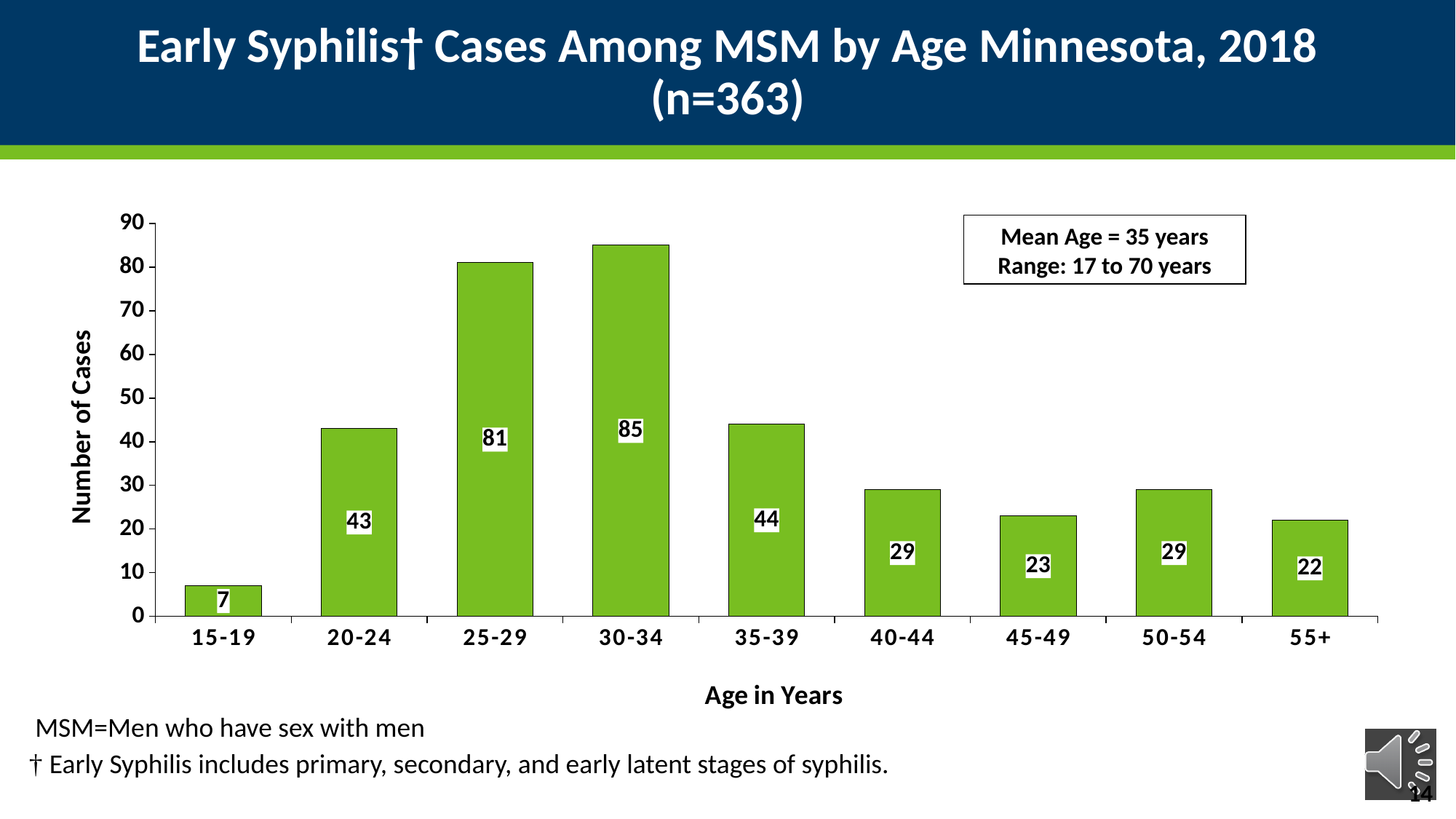
What is the difference in cases between the 30-34 and 25-29 age groups? 4 Which age group has the highest number of cases? 30-34 What is the label of the y axis? Number of Cases Which age group has the lowest number of cases? 15-19 What is the number of cases for the 55+ age group? 22 How many early syphilis cases among MSM were in the 25-29 age group? 81 Is the value for the 40-44 age group greater or less than 40? less Do the number of cases rise or fall from the 30-34 age group to the 45-49 age group? fall What kind of chart is shown on the slide? bar chart Which age group has more cases, 20-24 or 35-39? 35-39 What is the mean age stated in the text box on the chart? 35 years How many age groups are shown on the x axis? 9